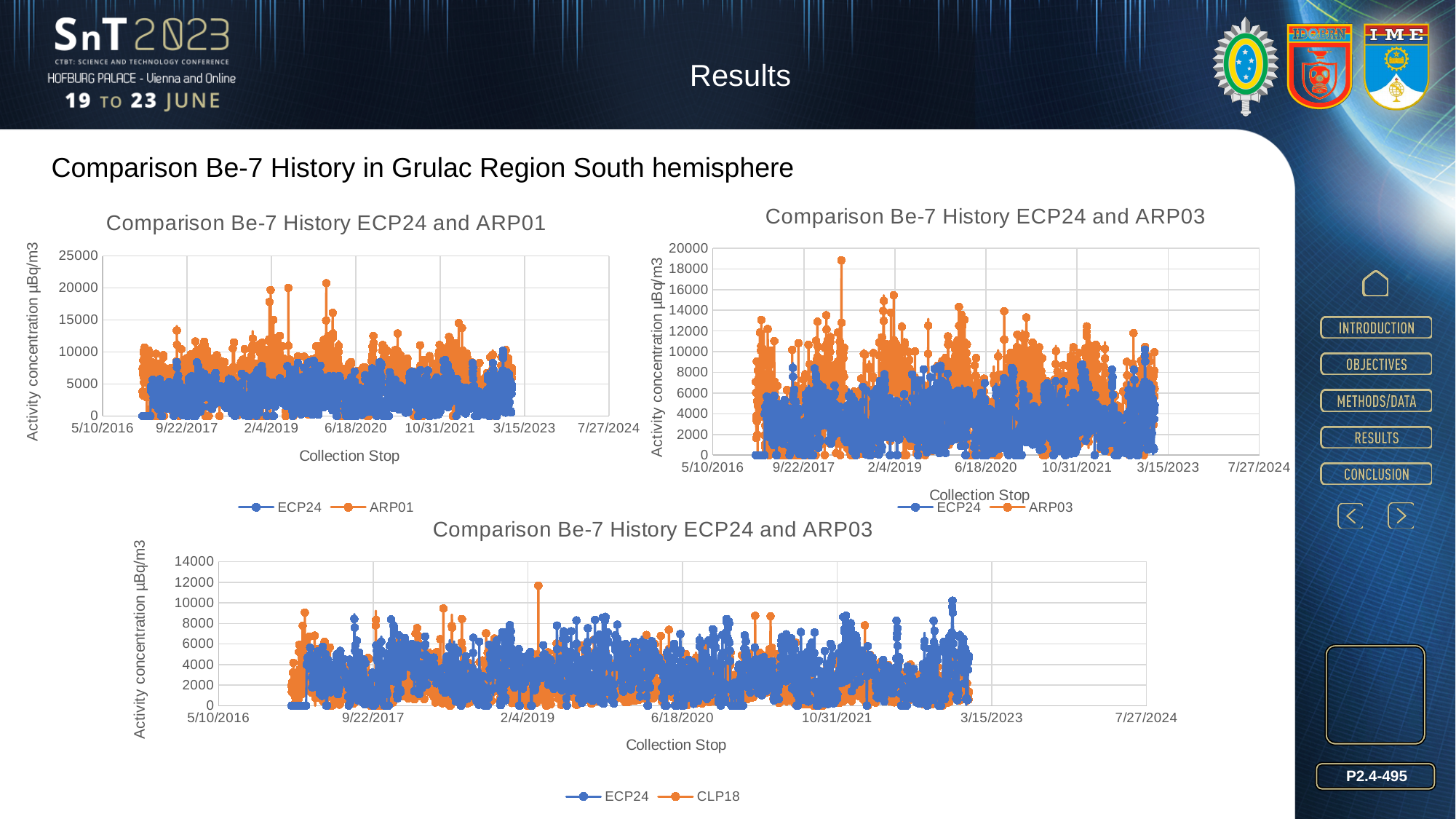
How many charts are shown on the slide? 3 In the top-left chart 'Comparison Be-7 History ECP24 and ARP01', which series reaches the higher peak value, ECP24 or ARP01? ARP01 Which two series are listed in the legend of the bottom chart? ECP24 and CLP18 How many series does the legend of the top-left chart 'Comparison Be-7 History ECP24 and ARP01' list? 2 In the bottom chart, is the highest CLP18 value greater or less than 10000? greater In the top-left chart 'Comparison Be-7 History ECP24 and ARP01', is the highest ARP01 value greater or less than 20000? greater In the top-right chart 'Comparison Be-7 History ECP24 and ARP03', is the highest ARP03 value greater or less than 18000? greater How many series does the legend of the bottom chart list? 2 What type of chart is the top-left chart titled 'Comparison Be-7 History ECP24 and ARP01'? line chart In the top-right chart 'Comparison Be-7 History ECP24 and ARP03', which series reaches the higher peak value, ECP24 or ARP03? ARP03 What is the x-axis title of the top-right chart 'Comparison Be-7 History ECP24 and ARP03'? Collection Stop